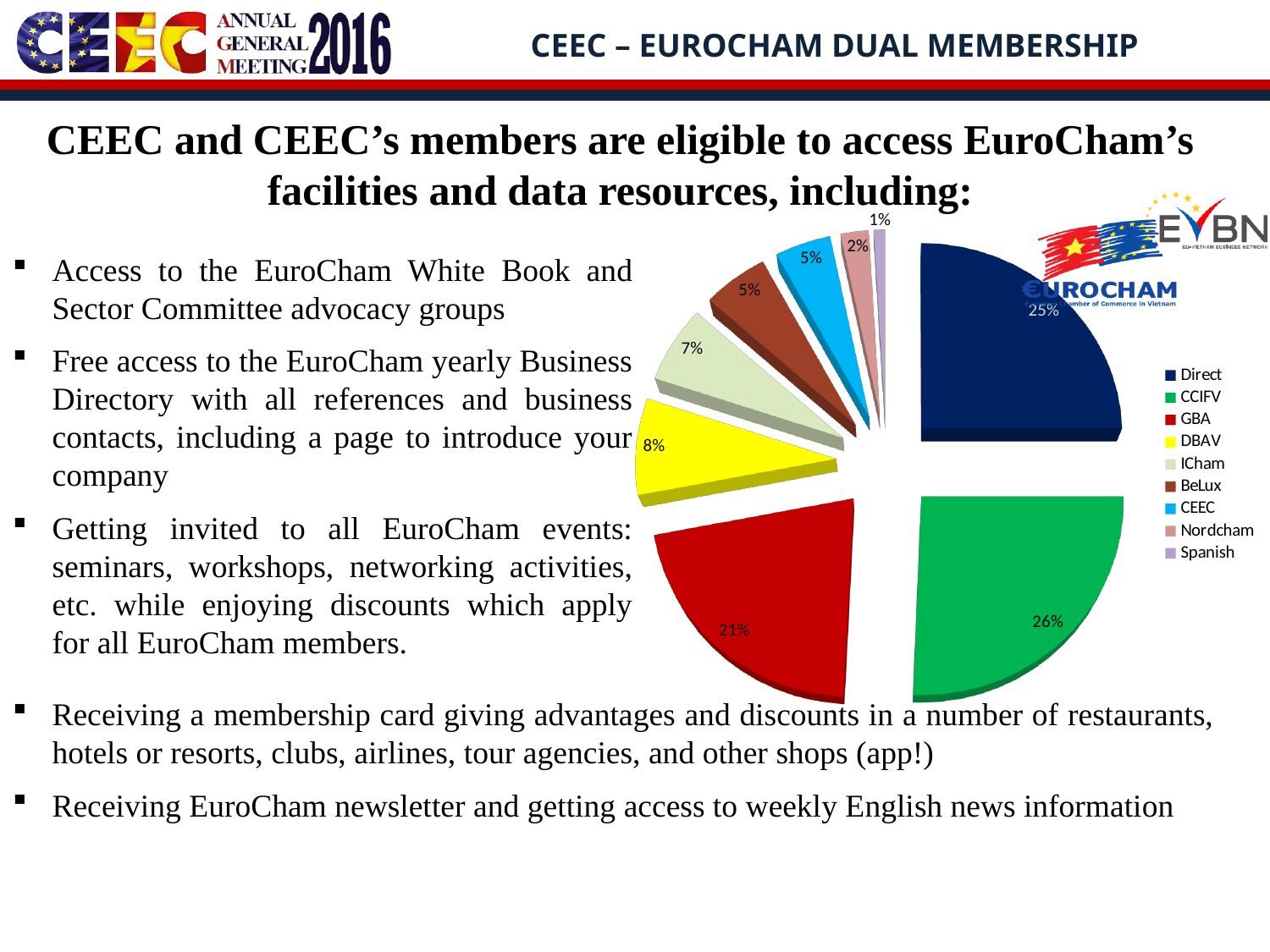
Which category has the largest slice of the pie? CCIFV What share of the pie does Direct hold? 25% What share of the pie does ICham hold? 7% What share of the pie does CCIFV hold? 26% How many categories does the pie chart's legend list? 9 Which category has the smallest slice of the pie? Spanish What share of the pie does DBAV hold? 8% What share of the pie does GBA hold? 21% What kind of chart is shown on the slide? Pie chart What share of the pie does Nordcham hold? 2% Which is larger, the share for DBAV or the share for ICham? DBAV What is the difference between the shares of CCIFV and GBA? 5%